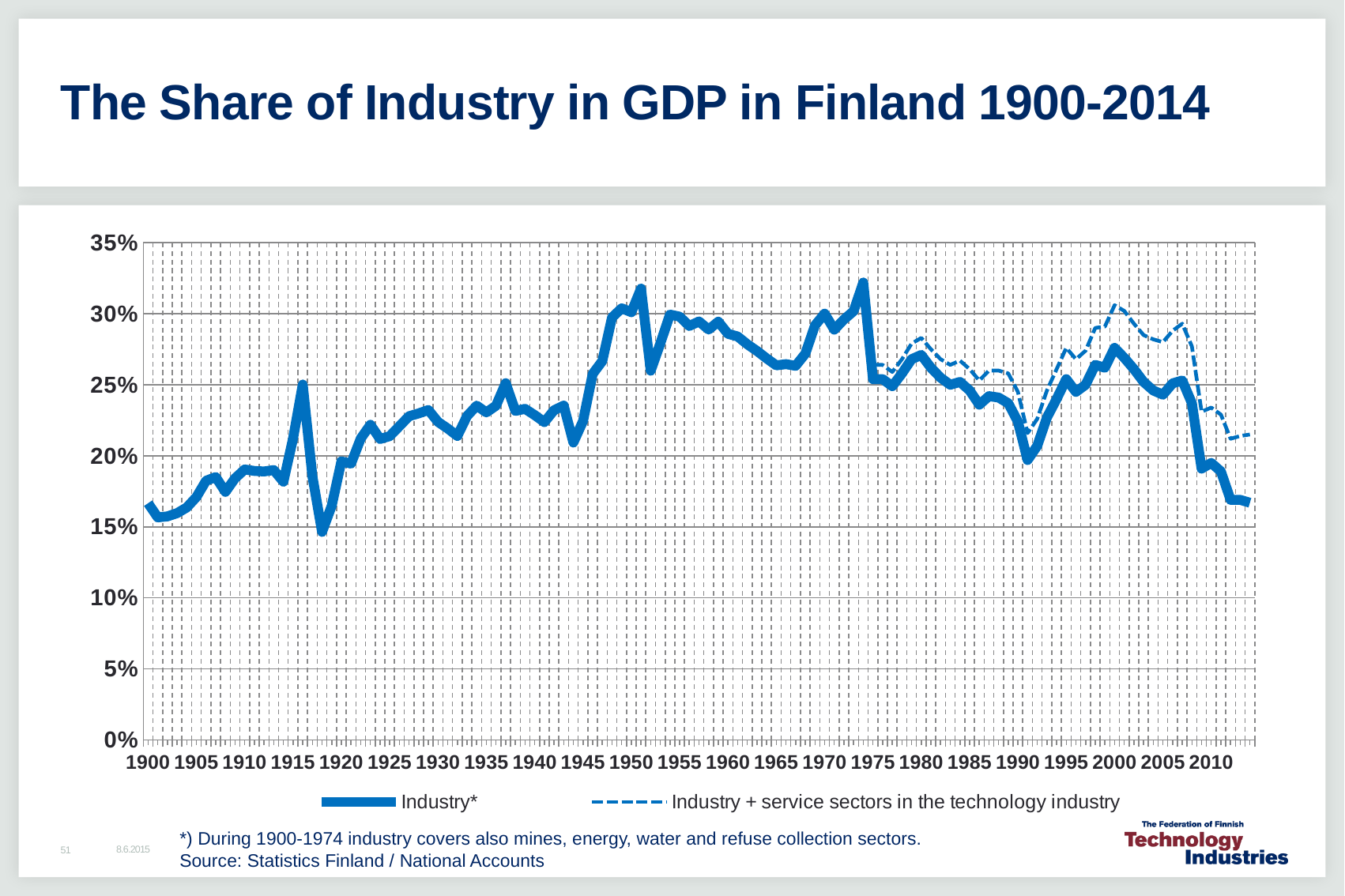
Is the value of Industry + service sectors in the technology industry in 2014 greater or less than 20%? greater Which series is drawn with a dashed line? Industry + service sectors in the technology industry Is the Industry* value in 1918 greater or less than 15%? less Is the Industry* value in 1900 greater or less than 20%? less Does the Industry* series rise or fall between 1945 and 1951? rise In 2010, which series has the higher value: Industry* or Industry + service sectors in the technology industry? Industry + service sectors in the technology industry Does the Industry* series rise or fall between 2008 and 2014? fall What is the title of the chart? The Share of Industry in GDP in Finland 1900-2014 How many series does the legend list? 2 What kind of chart is shown on the slide? line chart